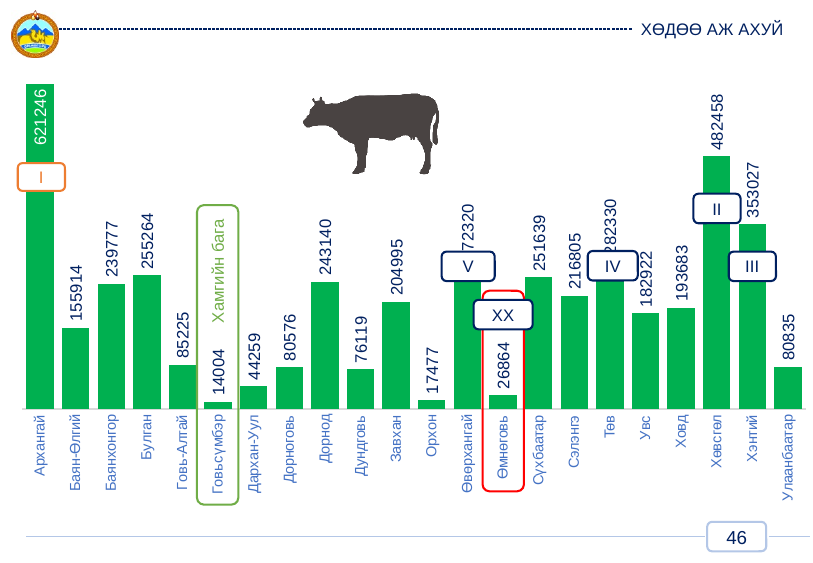
Which category has the lowest value? Говьсүмбэр What is the difference between the values for Архангай and Хөвсгөл? 138788 What is the value for Хөвсгөл? 482458 What is the value for Архангай? 621246 What kind of chart is shown on the slide? Bar chart Which is larger, the value for Орхон or the value for Өмнөговь? Өмнөговь What is the difference between the values for Хэнтий and Төв? 70697 Which is larger, the value for Дорнод or the value for Сүхбаатар? Сүхбаатар How many categories are shown on the x axis? 22 What is the value for Говьсүмбэр? 14004 What is the value for Төв? 282330 Which category has the highest value? Архангай